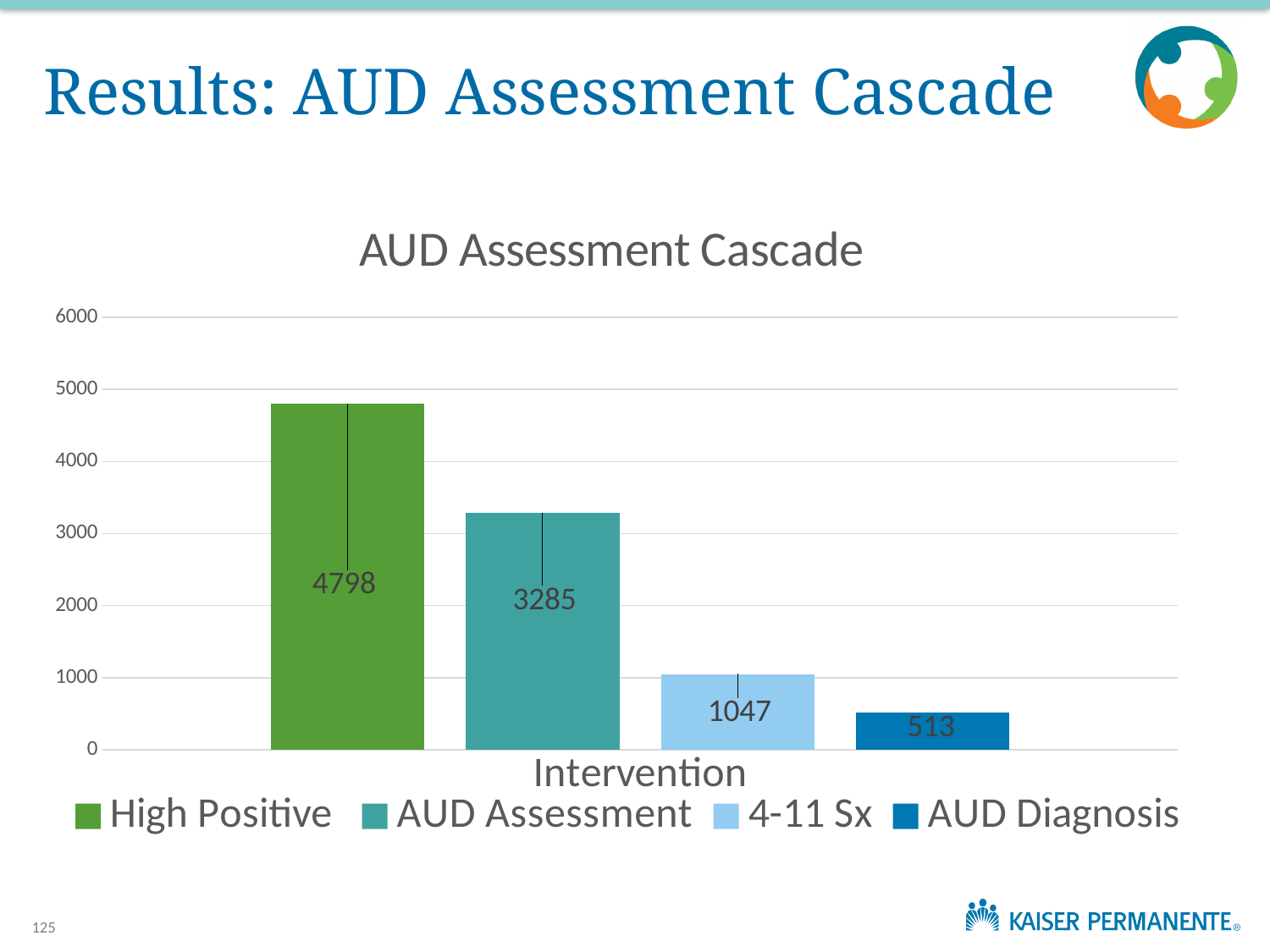
Which is larger, the value for AUD Assessment or the value for 4-11 Sx? AUD Assessment What kind of chart is shown? Bar chart What is the value for AUD Assessment? 3285 Which series has the highest value? High Positive How many series does the legend list? 4 What is the value for High Positive? 4798 What is the difference between the 4-11 Sx and AUD Diagnosis values? 534 What is the difference between the High Positive and AUD Assessment values? 1513 What is the value for AUD Diagnosis? 513 What is the value for 4-11 Sx? 1047 What is the title of the chart? AUD Assessment Cascade Which series has the lowest value? AUD Diagnosis